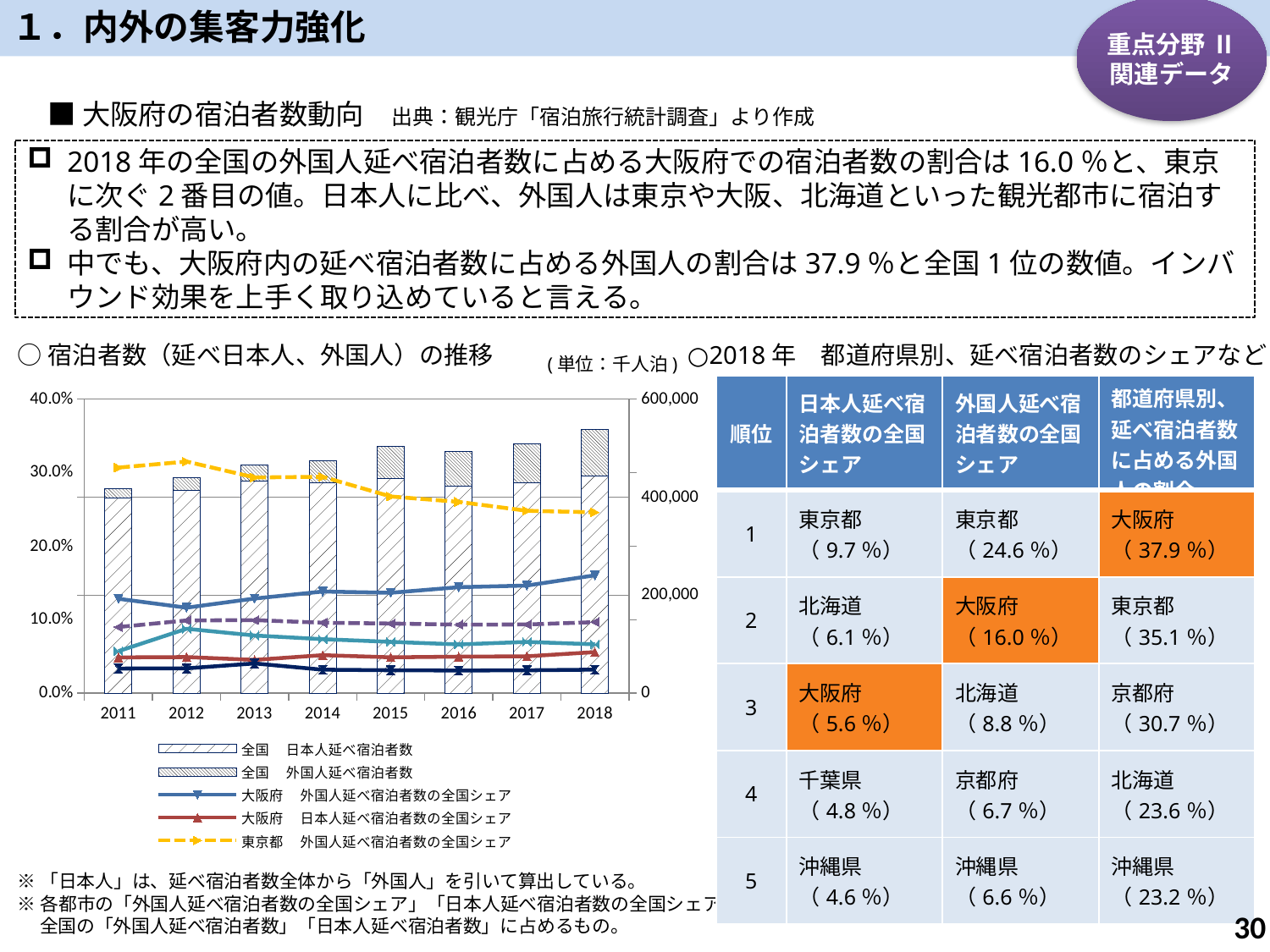
Does the 大阪府 外国人延べ宿泊者数の全国シェア line rise or fall from 2012 to 2018? Rise In which year is the total stacked bar (全国 延べ宿泊者数) the tallest? 2018 What is the last year shown on the x axis of the chart? 2018 In 2018, which is larger: the 東京都 外国人延べ宿泊者数の全国シェア or the 大阪府 外国人延べ宿泊者数の全国シェア? 東京都 外国人延べ宿泊者数の全国シェア Is the 東京都 外国人延べ宿泊者数の全国シェア value for 2018 greater or less than 30.0%? less Does the 東京都 外国人延べ宿泊者数の全国シェア line rise or fall from 2012 to 2018? Fall Is the 大阪府 外国人延べ宿泊者数の全国シェア value for 2018 greater or less than 10.0%? greater In which year is the total stacked bar (全国 延べ宿泊者数) the shortest? 2011 In which year is the 大阪府 外国人延べ宿泊者数の全国シェア line at its highest? 2018 What kind of chart is used for the 全国 宿泊者数 series? Stacked bar chart (with line series overlaid) What is the first year shown on the x axis of the chart? 2011 How many years are shown on the x axis of the chart? 8